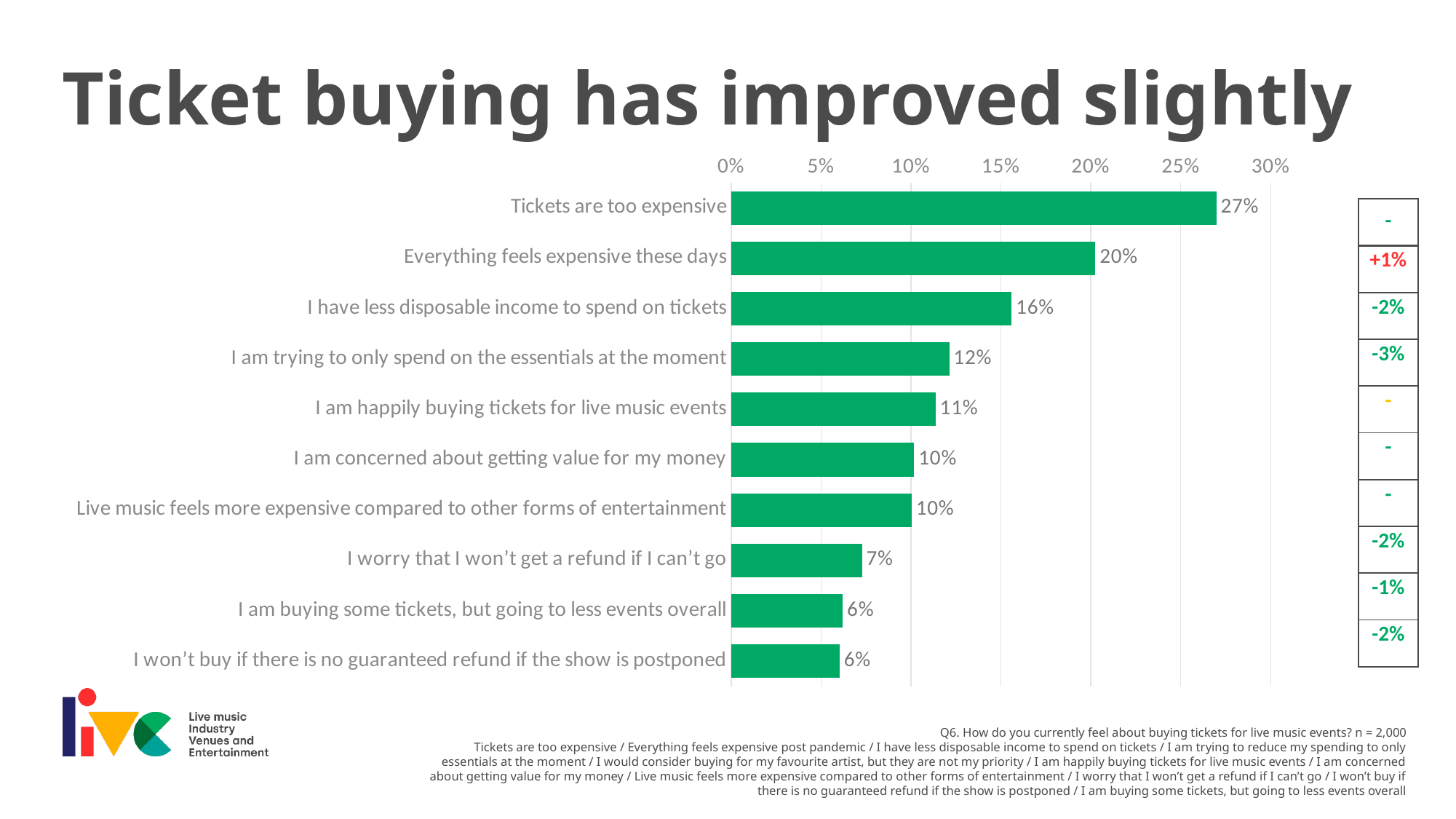
What is the difference between 'I have less disposable income to spend on tickets' and 'I am buying some tickets, but going to less events overall'? 10% What kind of chart is shown on the slide? Bar chart What is the difference between 'Tickets are too expensive' and 'Everything feels expensive these days'? 7% How many categories are shown in the chart? 10 What percentage said 'I am happily buying tickets for live music events'? 11% What is the value for 'I have less disposable income to spend on tickets'? 16% What is the value for 'I worry that I won't get a refund if I can't go'? 7% What is the highest value shown on the percentage axis? 30% Which category has the highest value? Tickets are too expensive What percentage of respondents said tickets are too expensive? 27% What is the title of the slide? Ticket buying has improved slightly Which is larger: 'I am trying to only spend on the essentials at the moment' or 'I am concerned about getting value for my money'? I am trying to only spend on the essentials at the moment